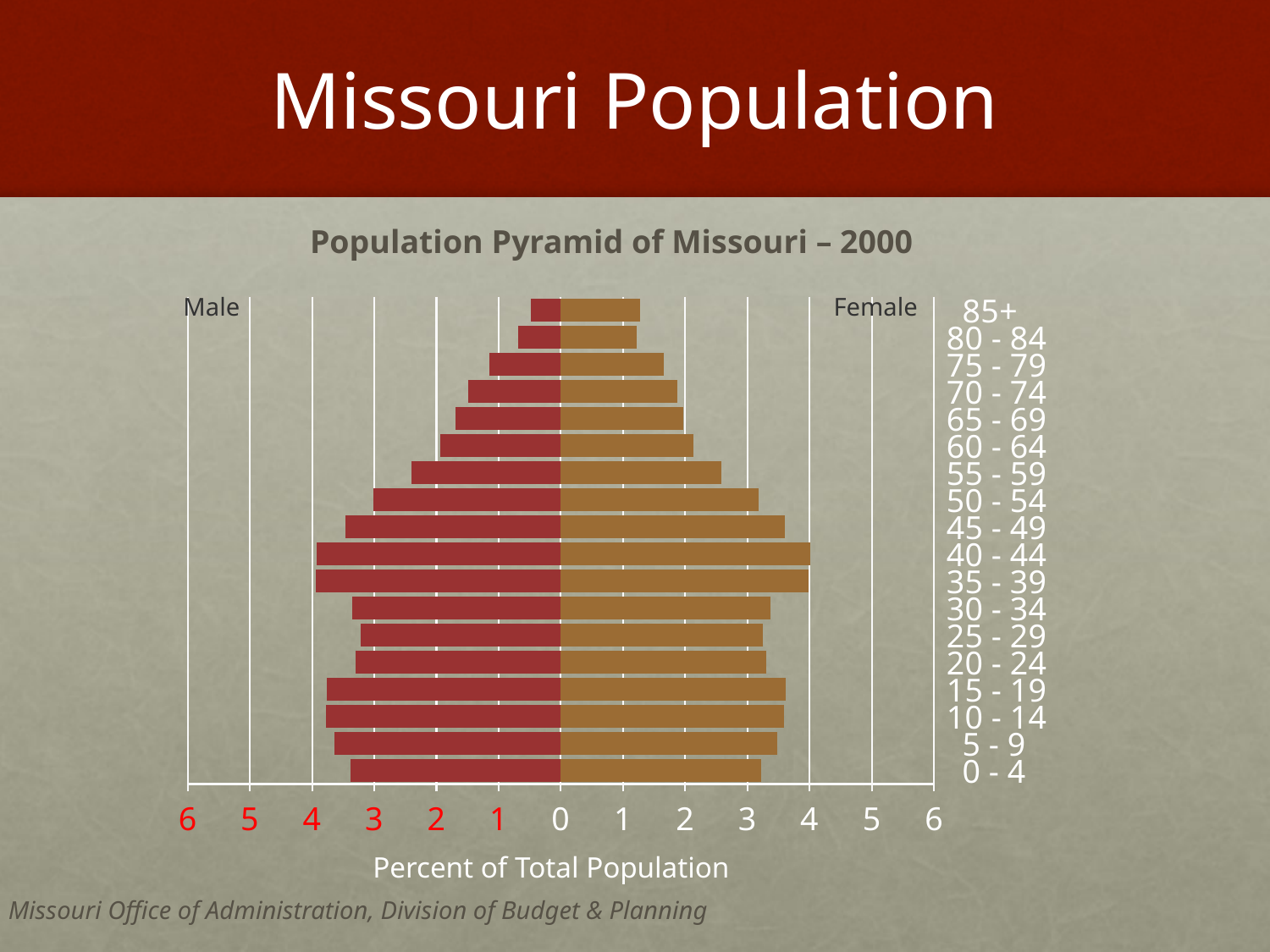
Is the Female value for the 85+ age group greater or less than 1? greater Is the Female value for the 55 - 59 age group greater or less than 2? greater Is the Male value for the 85+ age group greater or less than 1? less For the 85+ age group, which is larger, the Male value or the Female value? Female What is the label of the horizontal axis? Percent of Total Population How many age groups are shown on the population pyramid? 18 What is the title of the chart? Population Pyramid of Missouri – 2000 What kind of chart is shown on the slide? bar chart Which age group has the smallest Male value? 85+ How many series (sexes) does the population pyramid show? 2